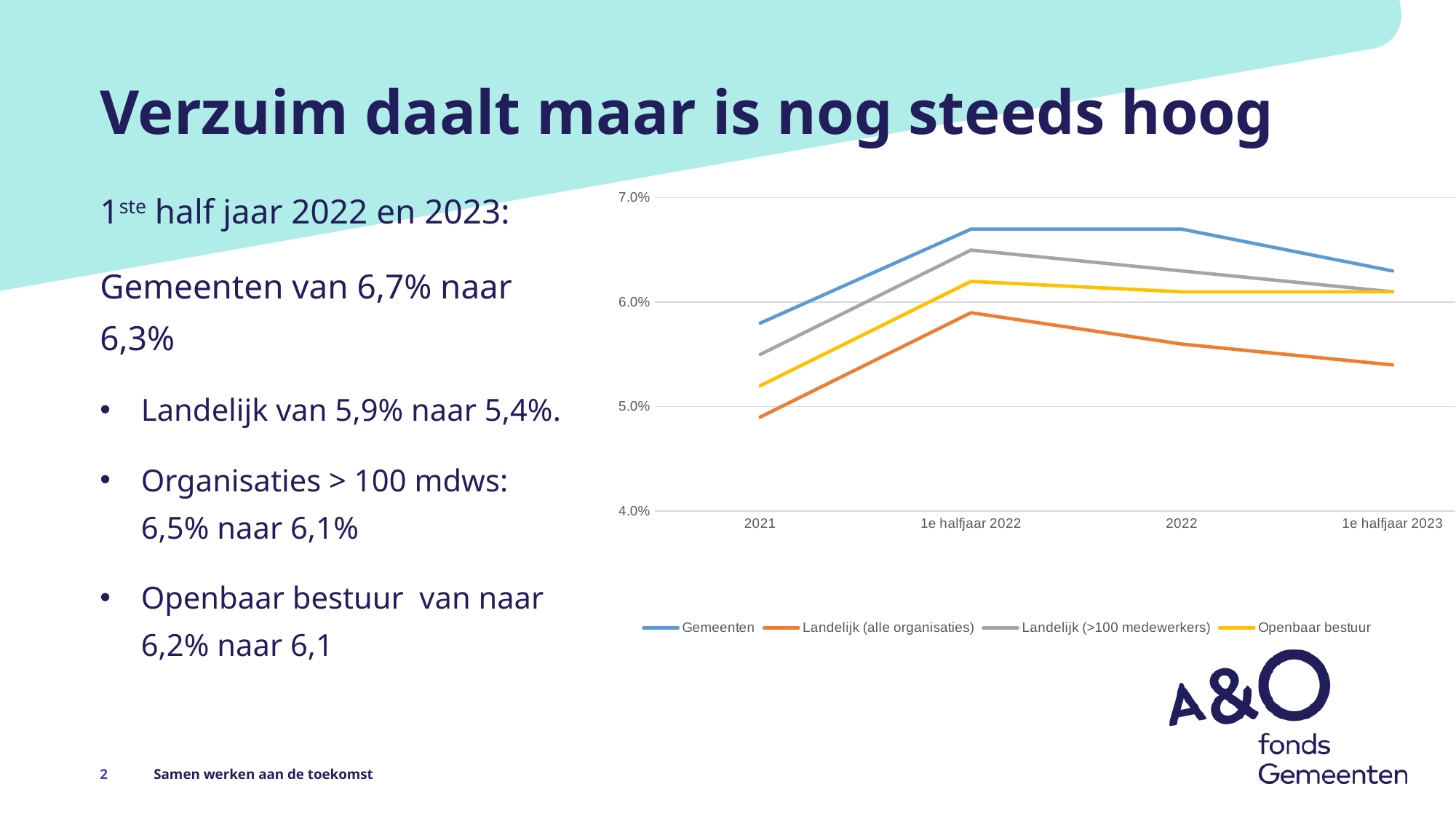
Is the value for Openbaar bestuur in 2021 greater or less than 5.0%? greater Does the Landelijk (alle organisaties) line rise or fall from 2021 to 1e halfjaar 2022? rise What kind of chart is shown on the slide? line chart Which is larger in 2022: the value for Gemeenten or the value for Landelijk (alle organisaties)? Gemeenten Which series has the highest value at 1e halfjaar 2022? Gemeenten How many series does the chart legend list? 4 Does the Gemeenten line rise or fall from 1e halfjaar 2022 to 1e halfjaar 2023? fall Which colour is used for the Openbaar bestuur line in the chart? yellow Which series has the lowest value at 1e halfjaar 2023? Landelijk (alle organisaties) Is the value for Landelijk (alle organisaties) in 2021 greater or less than 5.0%? less Is the value for Gemeenten in 2021 greater or less than 6.0%? less How many points are there along the x axis of the chart? 4